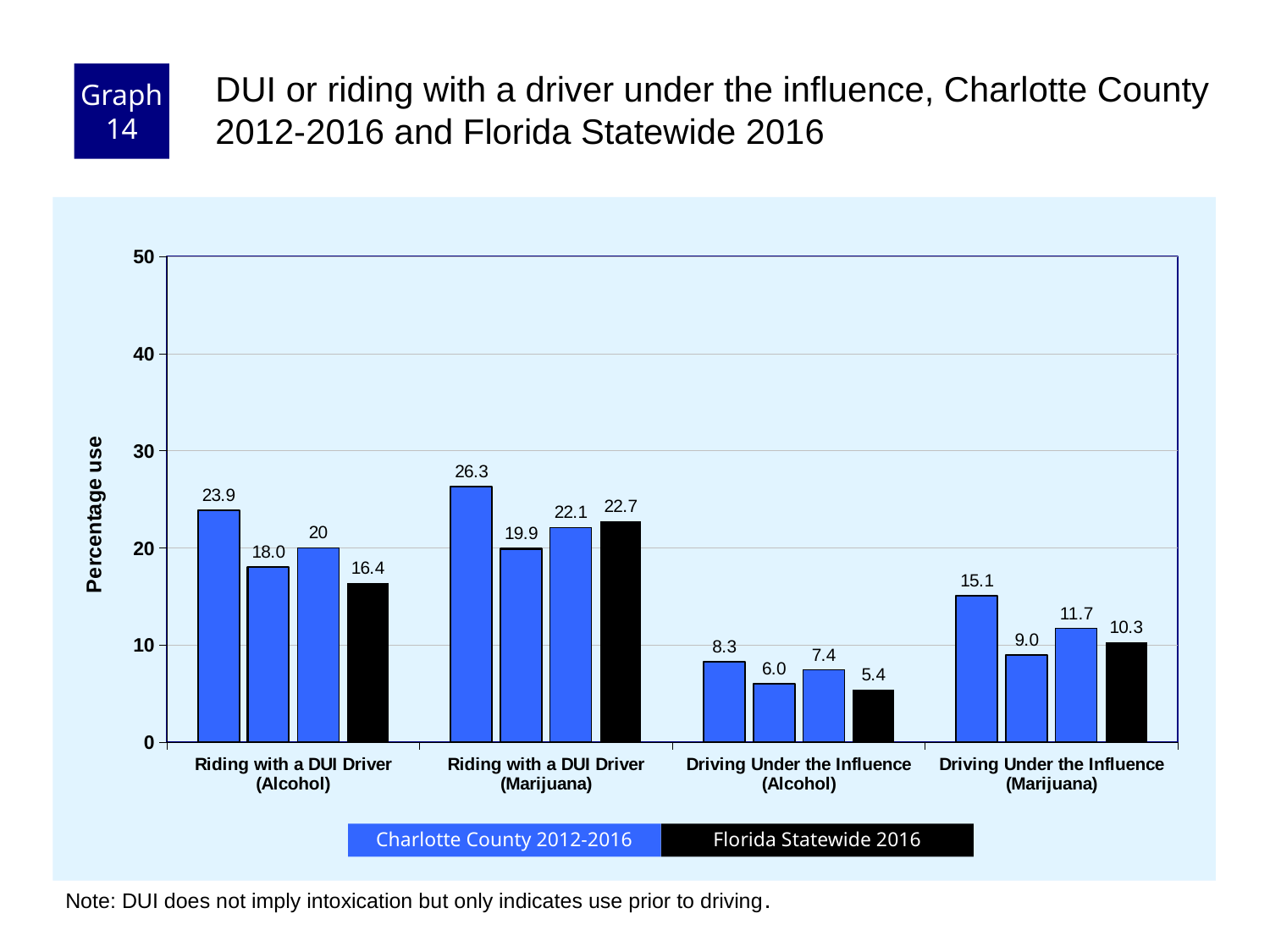
Which is larger: the Florida Statewide 2016 value for Driving Under the Influence (Marijuana) or for Driving Under the Influence (Alcohol)? Driving Under the Influence (Marijuana) Which category has the lowest Florida Statewide 2016 value? Driving Under the Influence (Alcohol) What type of chart is shown on the slide? bar chart How many categories are shown on the x axis? 4 What is the value of the first (leftmost) Charlotte County bar for Driving Under the Influence (Alcohol)? 8.3 Is the Florida Statewide 2016 value for Riding with a DUI Driver (Marijuana) greater or less than 20? greater Which category has the highest bar on the chart? Riding with a DUI Driver (Marijuana) How many series does the legend list? 2 What is the value of the first (leftmost) Charlotte County bar for Riding with a DUI Driver (Marijuana)? 26.3 What is the Florida Statewide 2016 value for Riding with a DUI Driver (Alcohol)? 16.4 What is the Florida Statewide 2016 value for Driving Under the Influence (Marijuana)? 10.3 What is the difference between the Florida Statewide 2016 values for Riding with a DUI Driver (Marijuana) and Riding with a DUI Driver (Alcohol)? 6.3